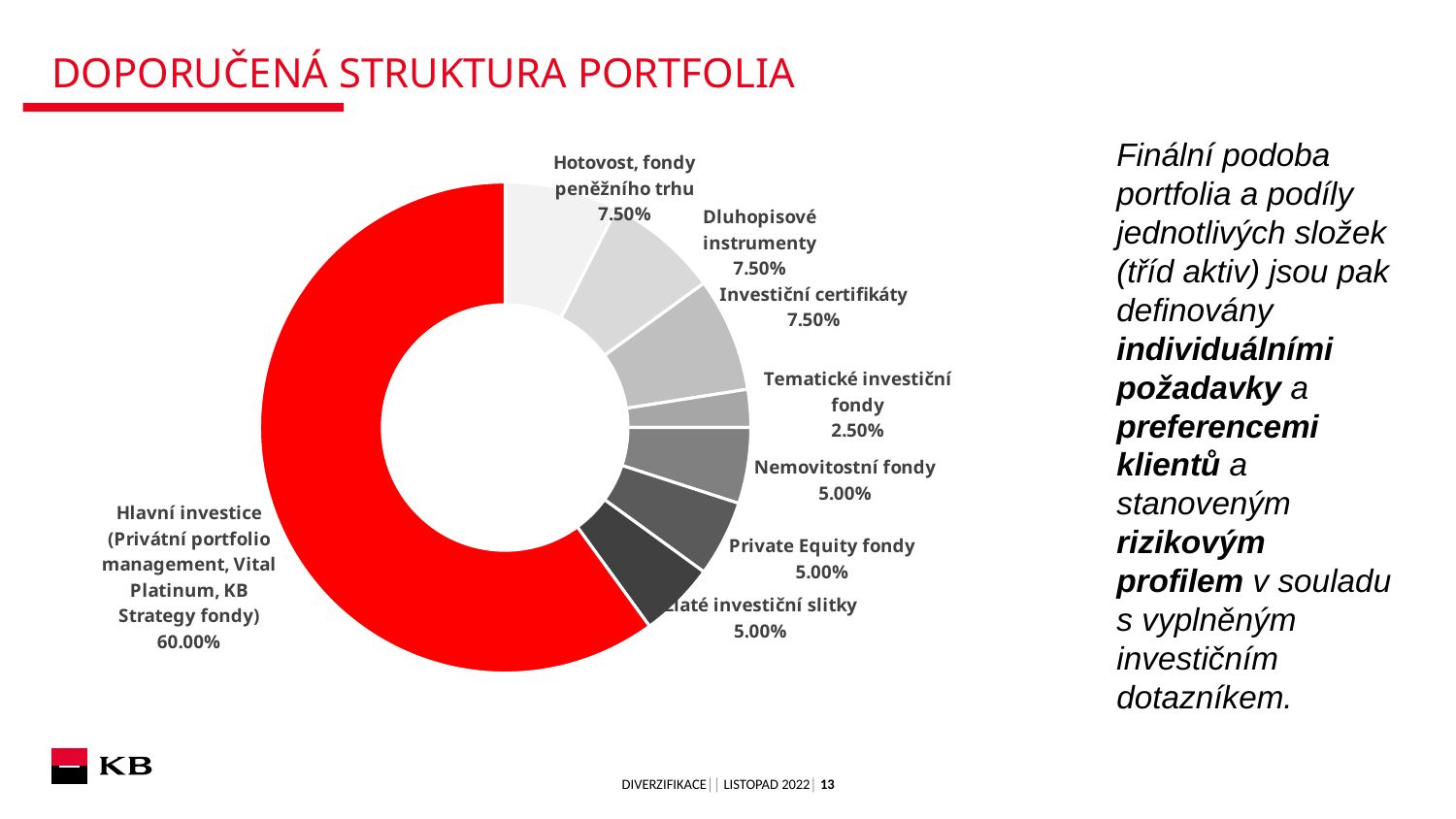
What colour is the slice for Hlavní investice? Red Which is larger, the share of Nemovitostní fondy or the share of Tematické investiční fondy? Nemovitostní fondy What percentage is shown for Dluhopisové instrumenty? 7.50% What kind of chart is shown on the slide? Doughnut (pie) chart Which category has the smallest share of the chart? Tematické investiční fondy What is the value shown for Hlavní investice in the chart? 60.00% What is the value for Tematické investiční fondy? 2.50% What percentage is shown for Nemovitostní fondy? 5.00% What is the difference between the share of Hlavní investice and the share of Investiční certifikáty? 52.50% Which category has the largest share of the chart? Hlavní investice What is the title of the slide containing the chart? DOPORUČENÁ STRUKTURA PORTFOLIA How many categories are shown in the chart? 8